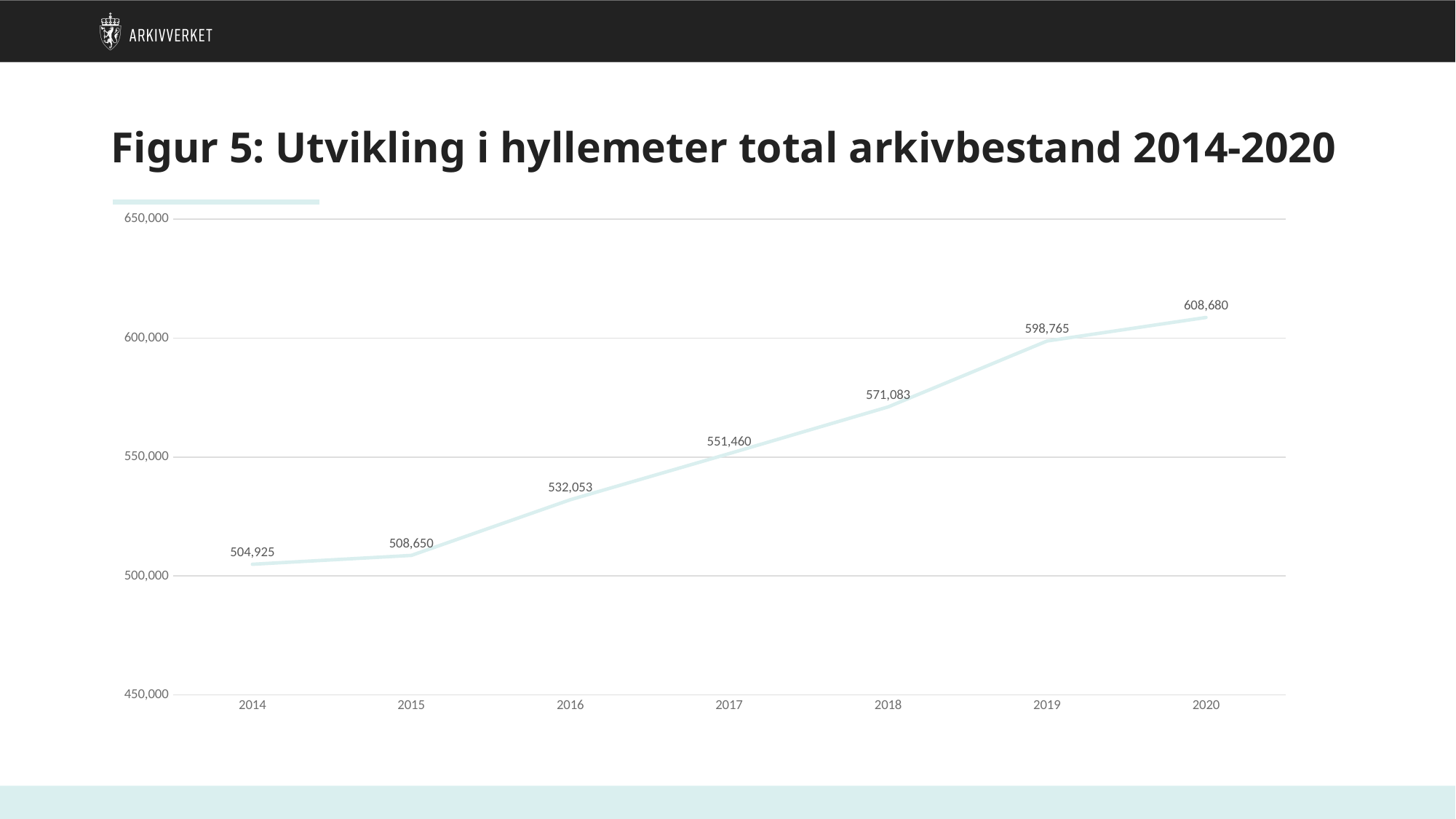
What is the difference between the values for 2020 and 2014? 103,755 What is the value for 2014? 504,925 Which year has the lowest value? 2014 How many years are plotted on the chart? 7 Which is larger, the value for 2016 or the value for 2018? 2018 What is the value for 2017? 551,460 Which year has the highest value? 2020 What is the value for 2020? 608,680 Is the value for 2019 greater or less than 600,000? less What kind of chart is shown on the slide? line chart Do the values rise or fall from 2014 to 2020? rise What is the difference between the values for 2019 and 2018? 27,682